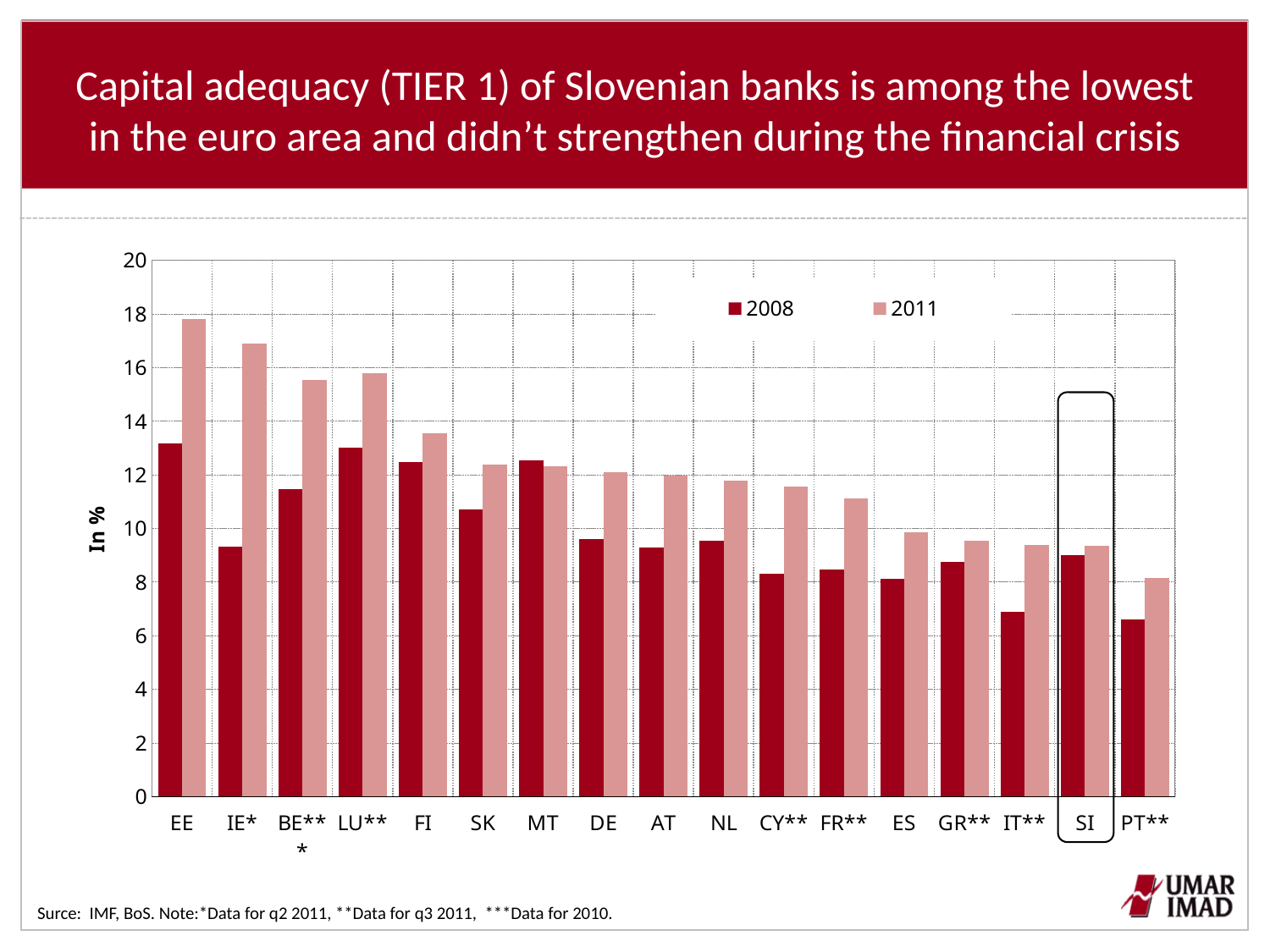
What is the label on the y axis? In % How many series does the legend list? 2 How many countries are shown on the x axis? 17 Which country has the highest 2011 value? EE Which is larger for DE: the 2008 value or the 2011 value? 2011 Which country has the lowest 2011 value? PT** Is the 2008 value for PT** greater or less than 8? less What kind of chart is shown on the slide? bar chart Which country has the larger 2011 value, SI or PT**? SI Is the 2011 value for EE greater or less than 16? greater Is the 2011 value for SI greater or less than 10? less